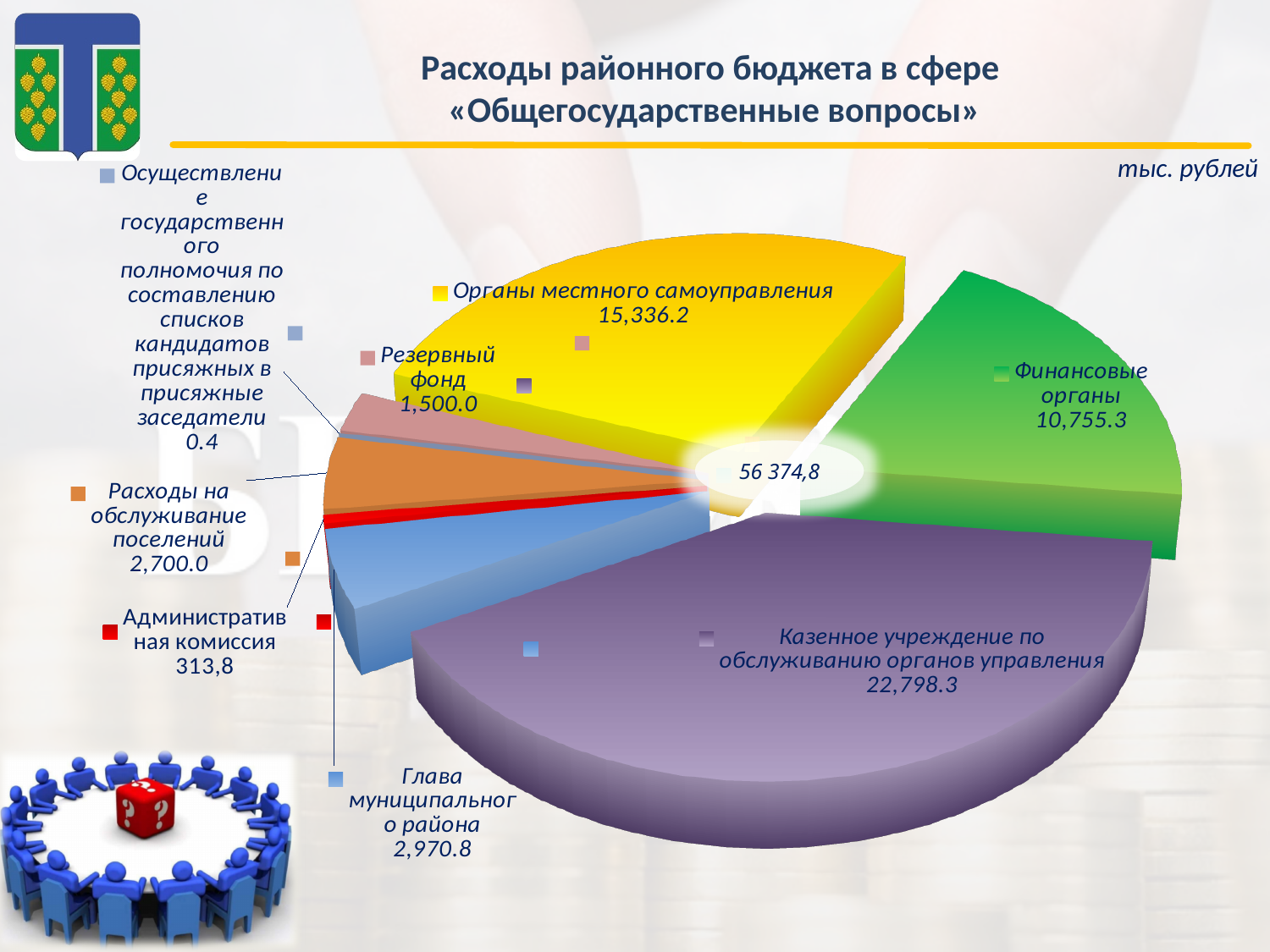
Which is larger: Глава муниципального района or Расходы на обслуживание поселений? Глава муниципального района What type of chart is shown on the slide? pie chart What unit of measurement is indicated for the chart values? тыс. рублей What is the value for Финансовые органы? 10,755.3 Which category has the largest slice of the pie? Казенное учреждение по обслуживанию органов управления What is the value for Административная комиссия? 313,8 Which category has the smallest value? Осуществление государственного полномочия по составлению списков кандидатов присяжных в присяжные заседатели What is the difference between the values for Казенное учреждение по обслуживанию органов управления and Органы местного самоуправления? 7,462.1 What is the value for Резервный фонд? 1,500.0 What is the value for Органы местного самоуправления? 15,336.2 What is the value for Казенное учреждение по обслуживанию органов управления? 22,798.3 How many categories are shown in the pie chart? 8